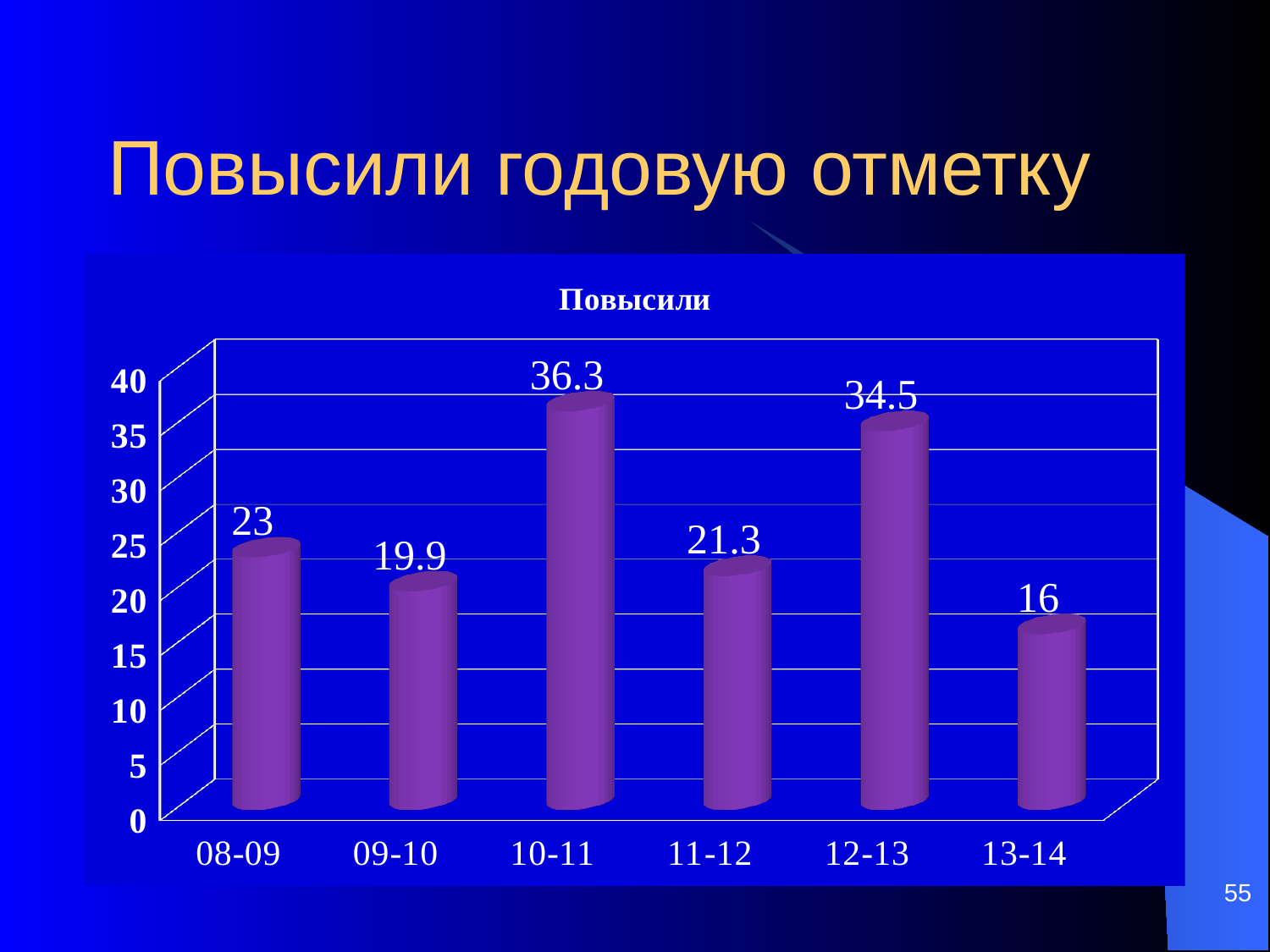
Which category has the highest value? 10-11 What is the value for 10-11? 36.3 Which is larger, the value for 08-09 or the value for 11-12? 08-09 What kind of chart is this? bar chart What is the value for 13-14? 16 What is the difference between the values for 10-11 and 12-13? 1.8 What is the difference between the values for 08-09 and 13-14? 7 How many categories are shown on the x axis? 6 What is the value for 09-10? 19.9 What is the title of the chart? Повысили Which category has the lowest value? 13-14 Is the value for 12-13 greater or less than 30? greater